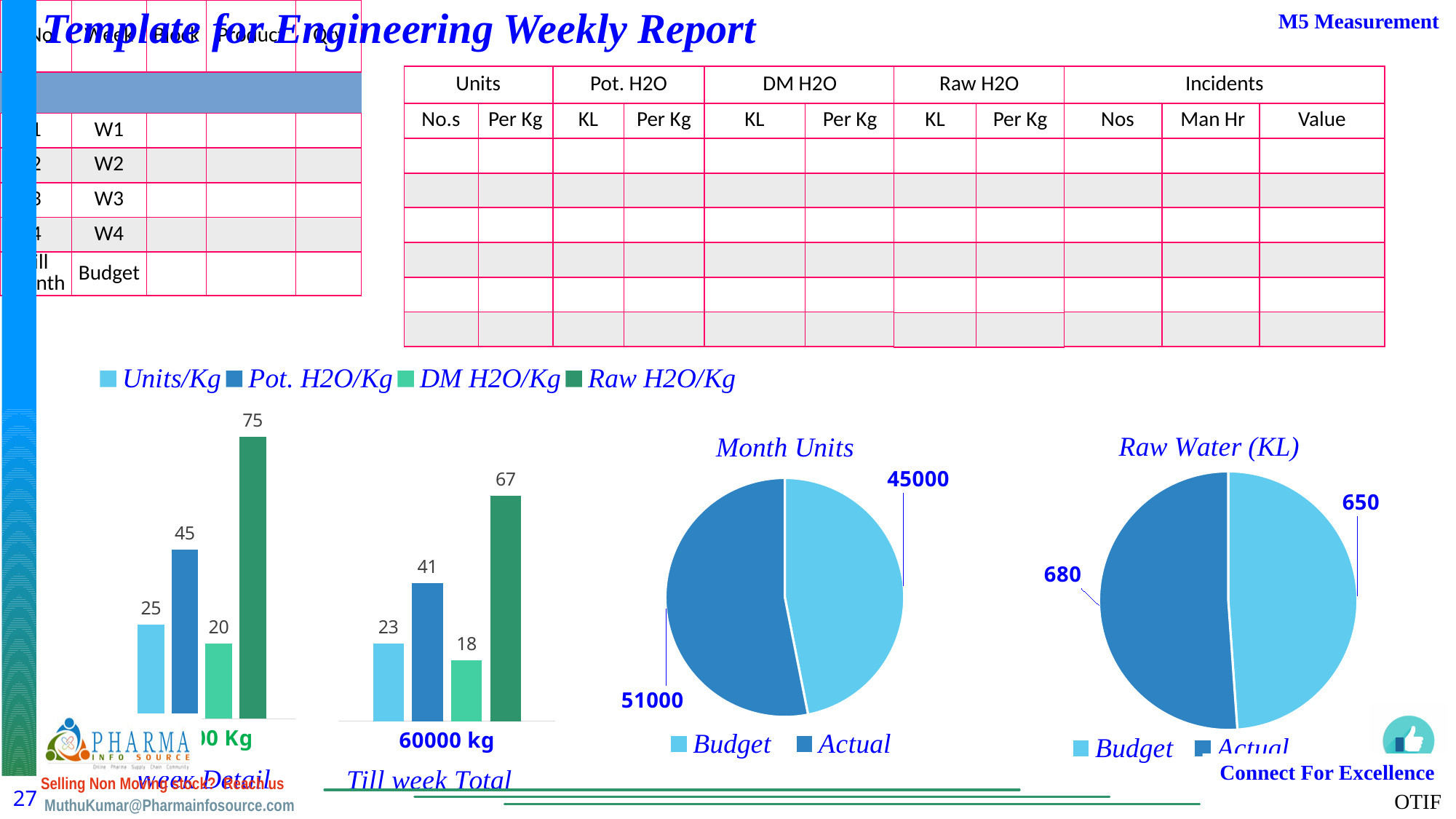
In the bar chart, what is the value of Pot. H2O/Kg for Till week Total? 41 In the Month Units pie chart, what is the Actual value? 51000 In the bar chart, which series has the highest value for Week Detail? Raw H2O/Kg In the Raw Water (KL) pie chart, what is the Budget value? 650 What kind of chart is the Month Units chart? pie chart How many series does the legend of the bar chart list? 4 In the Raw Water (KL) pie chart, what is the difference between Actual and Budget? 30 In the bar chart, what is the value of DM H2O/Kg for Till week Total? 18 In the bar chart, what is the value of Raw H2O/Kg for Week Detail? 75 In the bar chart, which is larger: Units/Kg for Week Detail or Units/Kg for Till week Total? Units/Kg for Week Detail In the bar chart, which series has the lowest value for Till week Total? DM H2O/Kg In the bar chart, what is the difference between Raw H2O/Kg for Week Detail and Raw H2O/Kg for Till week Total? 8